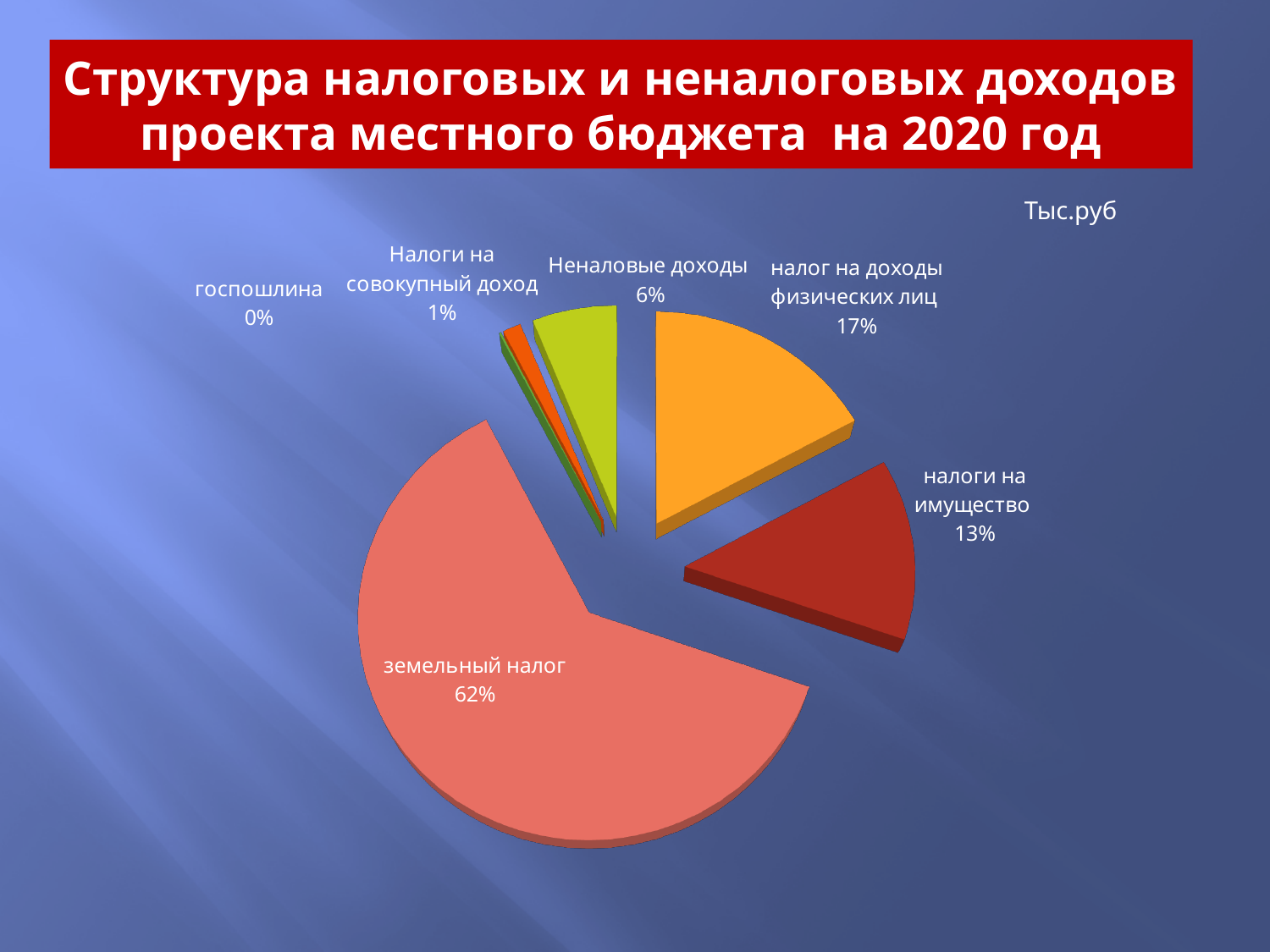
What is the difference in percentage points between налог на доходы физических лиц and налоги на имущество? 4 percentage points What share of the pie does Неналовые доходы have? 6% Which category has the smallest share of the pie? госпошлина What share of the pie does налог на доходы физических лиц have? 17% Which is larger: the share for Неналовые доходы or the share for налоги на имущество? налоги на имущество What share of the pie does земельный налог have? 62% How many categories are shown in the pie chart? 6 Which category has the largest share of the pie? земельный налог What kind of chart is shown on the slide? Pie chart